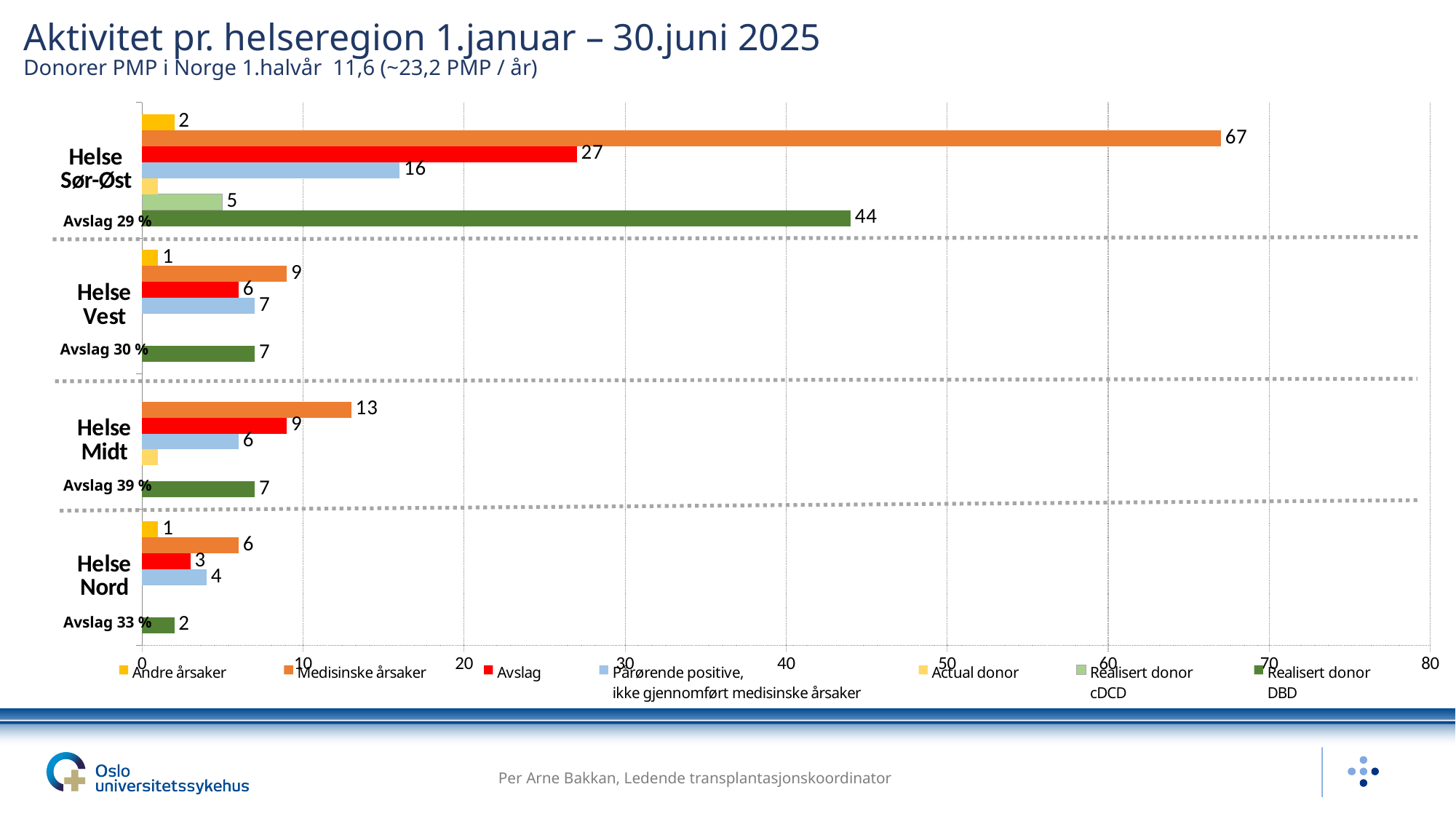
What is the value of Medisinske årsaker for Helse Sør-Øst? 67 What is the value of Pårørende positive, ikke gjennomført medisinske årsaker for Helse Nord? 4 Which is larger for Helse Vest: Medisinske årsaker or Avslag? Medisinske årsaker How many health regions (categories) are shown on the chart? 4 Which region has the lowest value for Realisert donor DBD? Helse Nord What is the difference between Medisinske årsaker and Avslag for Helse Sør-Øst? 40 What type of chart is shown on the slide? bar chart What Avslag percentage is shown for Helse Midt? 39 % What is the value of Avslag for Helse Midt? 9 What is the value of Realisert donor DBD for Helse Sør-Øst? 44 How many series does the legend list? 7 Which region has the highest value for Medisinske årsaker? Helse Sør-Øst